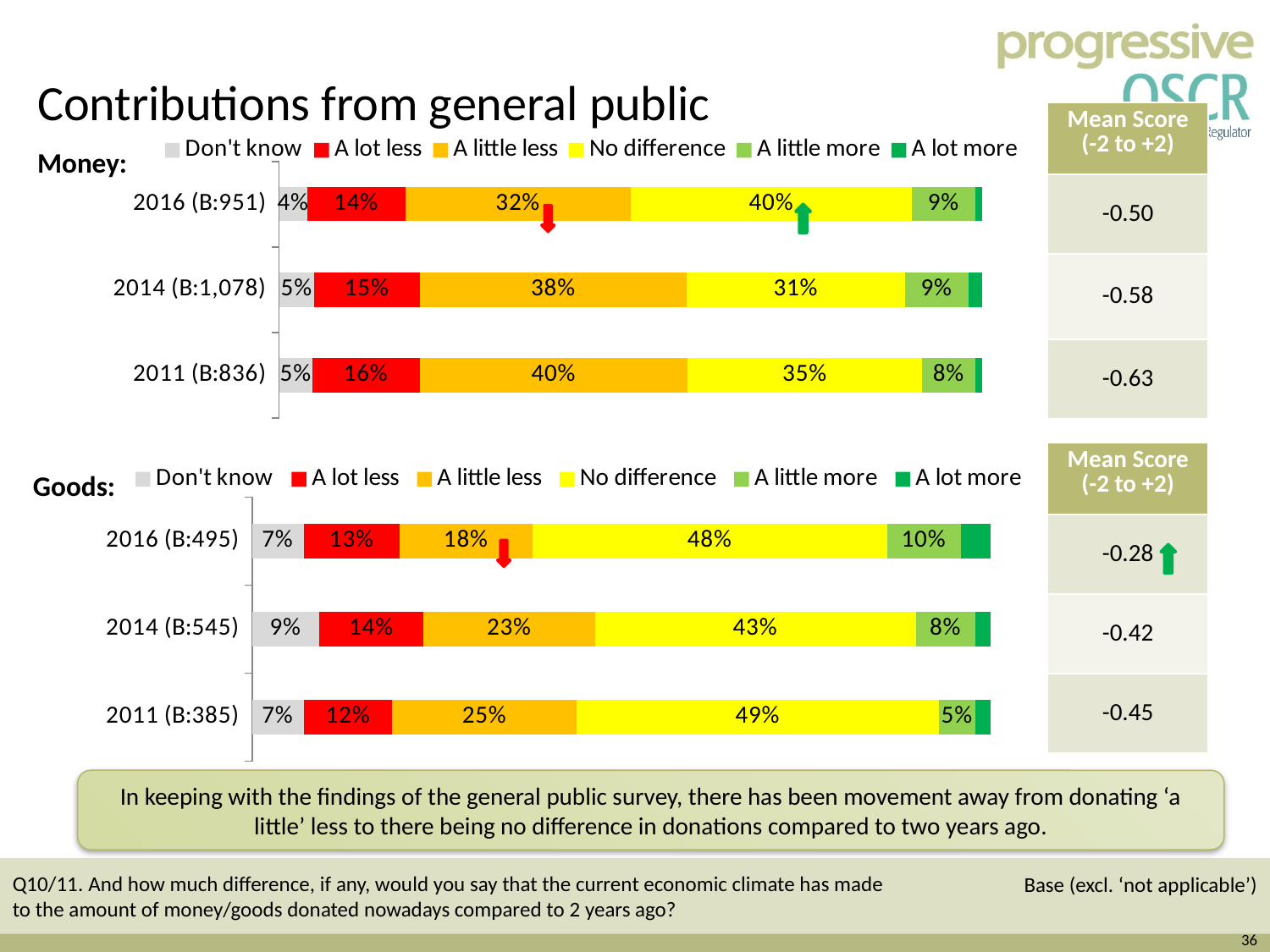
In the Goods chart, is the 'A little less' percentage larger in 2014 (B:545) or in 2016 (B:495)? 2014 (B:545) In the Goods chart, what percentage said 'Don't know' in 2014 (B:545)? 9% In the Money chart, what percentage of respondents in 2016 (B:951) said 'No difference'? 40% What type of chart is used for the Money data? Stacked bar chart In the Money chart, which year has the lowest 'A little less' percentage? 2016 (B:951) In the Money chart, what percentage said 'A lot less' in 2014 (B:1,078)? 15% In the Money chart, what is the difference between the 'A little less' percentage in 2011 (B:836) and in 2016 (B:951)? 8% In the Goods chart, which year has the highest 'No difference' percentage? 2011 (B:385) In the Money chart, does the 'A lot less' percentage rise or fall from 2011 to 2016? Fall How many series does the legend of the Money chart list? 6 How many bars (years) are shown in the Goods chart? 3 In the Goods chart, what percentage of respondents in 2011 (B:385) said 'A little less'? 25%